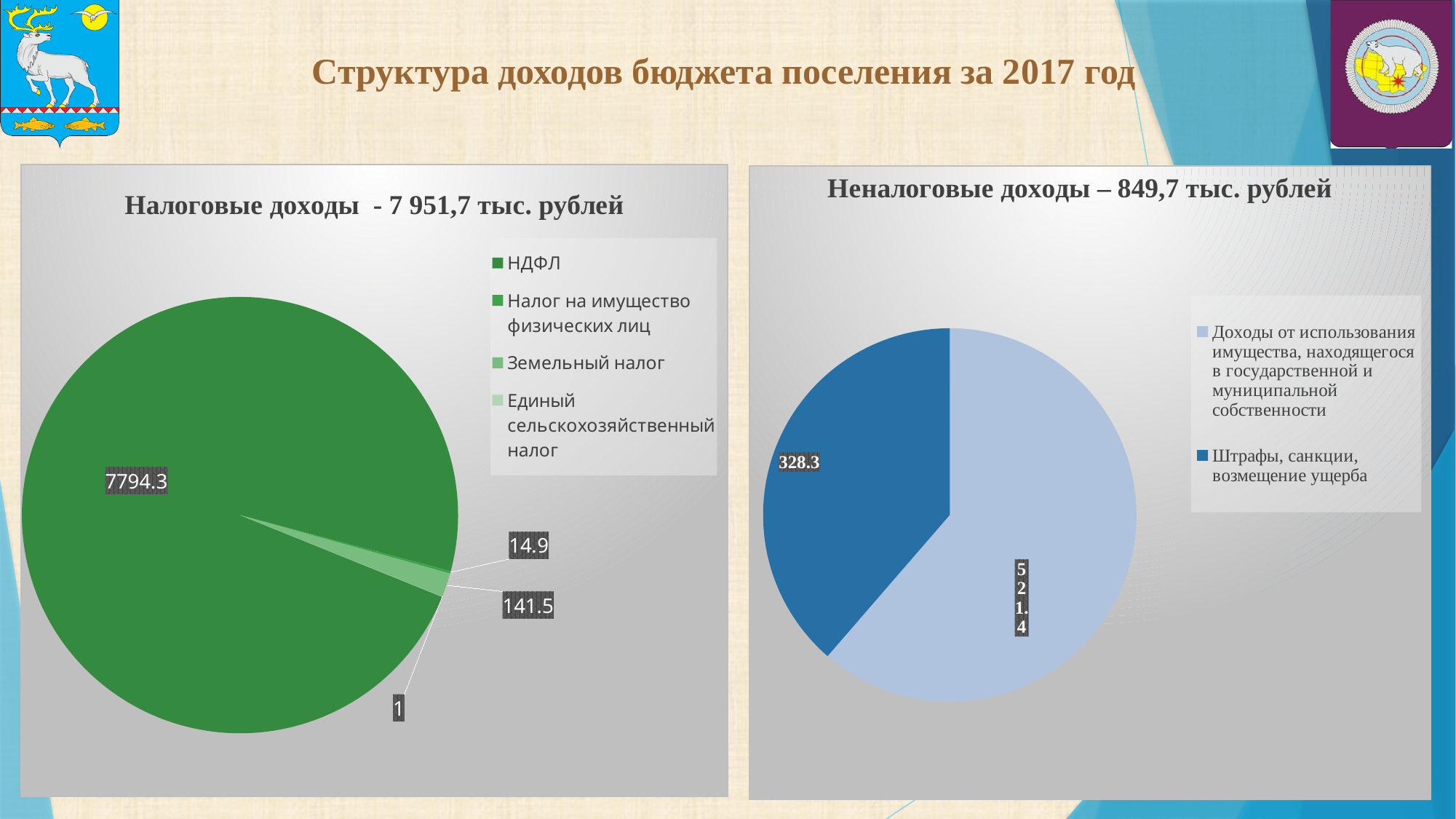
In the right chart (Неналоговые доходы), what is the difference between the two slice values? 193.1 How many slices does the right chart (Неналоговые доходы) have? 2 In the left chart (Налоговые доходы), what is the difference between the НДФЛ value and the Земельный налог value? 7652.8 In the left chart (Налоговые доходы), which category has the smallest slice? Единый сельскохозяйственный налог What kind of chart is the left chart titled 'Налоговые доходы - 7 951,7 тыс. рублей'? pie chart In the left chart (Налоговые доходы), what is the value for НДФЛ? 7794.3 In the right chart (Неналоговые доходы), which is larger: Доходы от использования имущества or Штрафы, санкции, возмещение ущерба? Доходы от использования имущества How many categories does the legend of the left chart (Налоговые доходы) list? 4 In the left chart (Налоговые доходы), which category has the largest slice? НДФЛ In the right chart (Неналоговые доходы), what is the value for Доходы от использования имущества, находящегося в государственной и муниципальной собственности? 521.4 In the right chart (Неналоговые доходы), what is the value for Штрафы, санкции, возмещение ущерба? 328.3 In the left chart (Налоговые доходы), what is the value for Земельный налог? 141.5